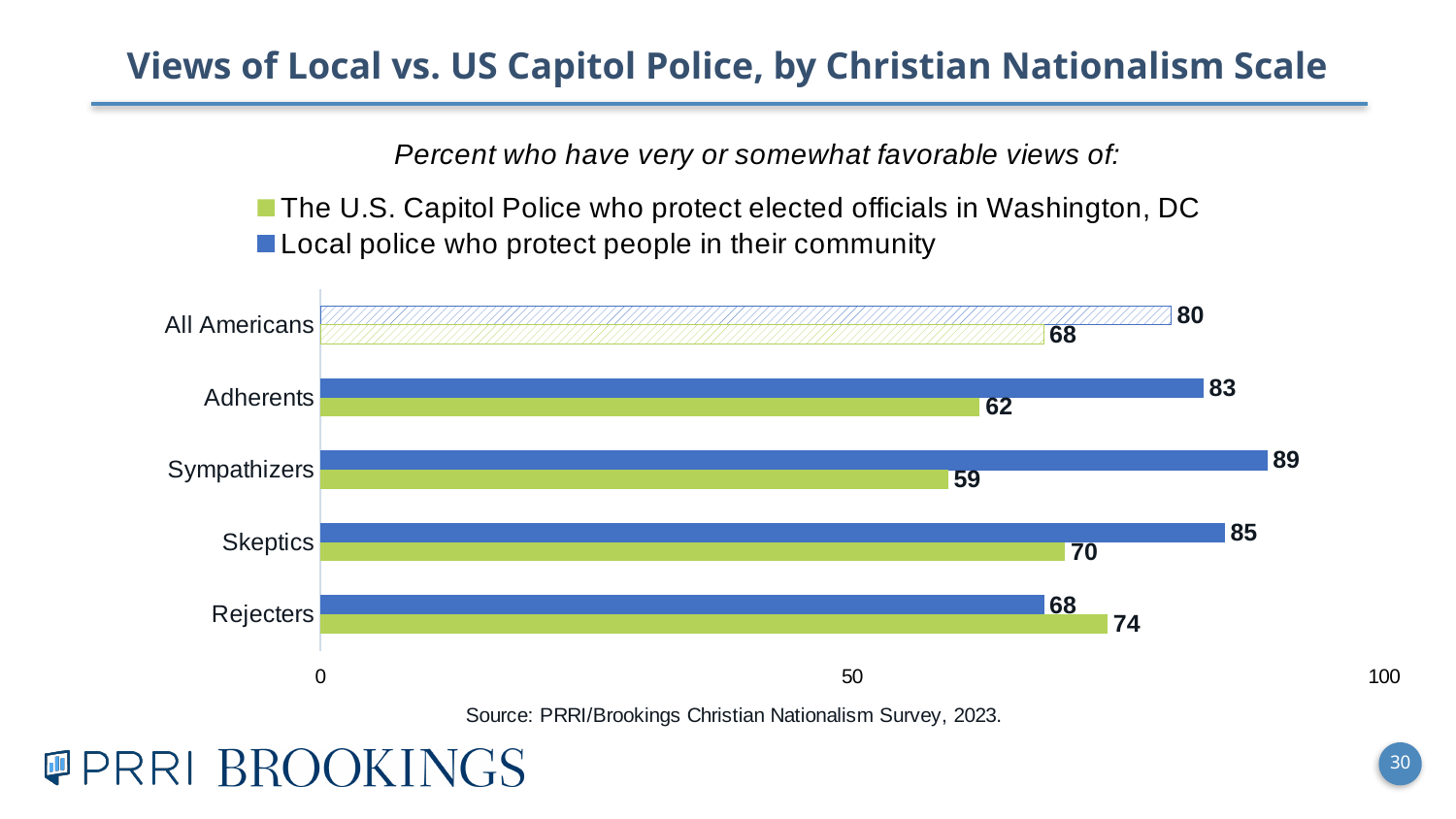
What is the value for Local police who protect people in their community among Sympathizers? 89 Is the value for The U.S. Capitol Police among Skeptics greater or less than 50? greater How many series does the legend list? 2 What is the value for The U.S. Capitol Police who protect elected officials in Washington, DC among Rejecters? 74 What is the source cited below the chart? PRRI/Brookings Christian Nationalism Survey, 2023 What is the value for Local police who protect people in their community among All Americans? 80 For Rejecters, which is larger: the value for Local police or the value for the U.S. Capitol Police? The U.S. Capitol Police How many categories are shown on the y axis? 5 What is the difference between the Local police value and the U.S. Capitol Police value for Adherents? 21 Which category has the lowest value for The U.S. Capitol Police who protect elected officials in Washington, DC? Sympathizers What kind of chart is shown on the slide? bar chart Which category has the highest value for Local police who protect people in their community? Sympathizers